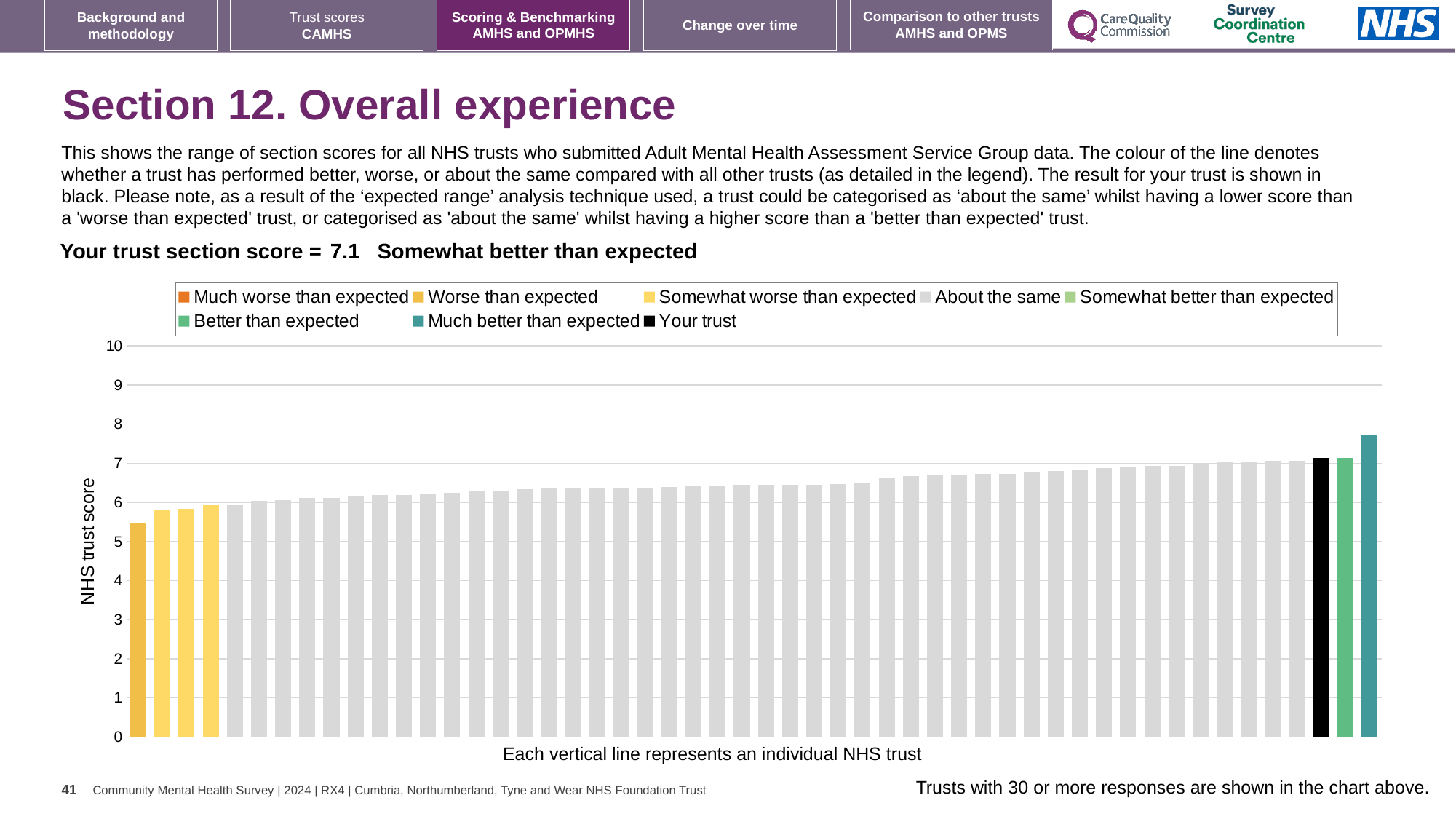
Is the value for your trust greater or less than 5? greater What is the section score for your trust shown on the slide? 7.1 Is the value of the tallest bar greater or less than 7? greater Do the bar values rise or fall from left to right along the x axis? rise Is the value of the leftmost bar greater or less than 6? less Which bar is the lowest in the chart? the leftmost bar Which bar is the highest in the chart? the rightmost bar (Much better than expected) What kind of chart is shown on the slide? bar chart Which is larger: the value for your trust (black bar) or the value of the leftmost bar? your trust What is the label on the vertical axis of the chart? NHS trust score What colour is the bar representing your trust? black How many entries does the chart legend list? 8